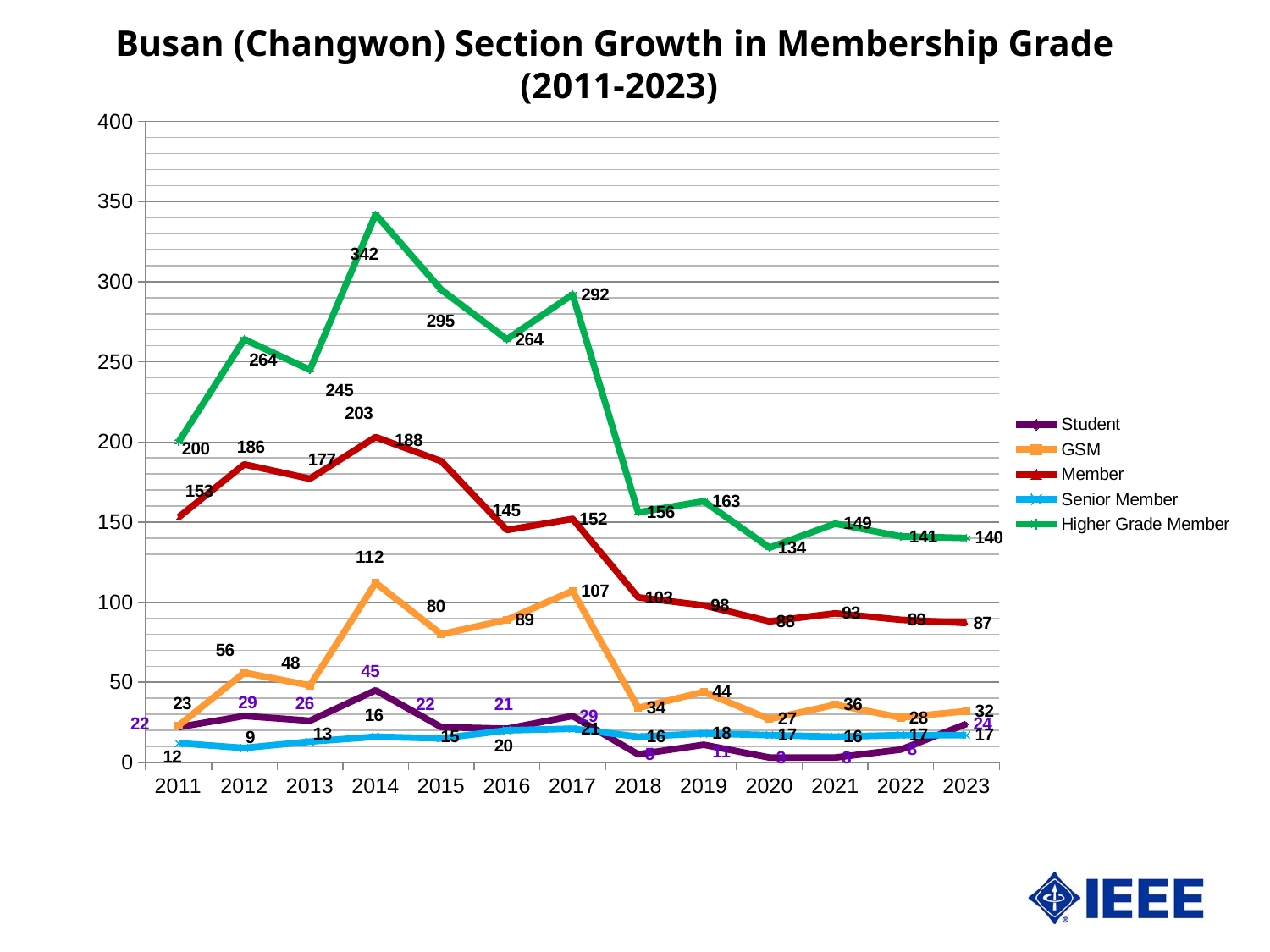
By how much did the Higher Grade Member value fall from 2017 to 2018? 136 In which year does the Higher Grade Member series reach its highest value? 2014 In 2023, which is larger: the Member value or the GSM value? Member How many years are plotted along the x axis? 13 What is the value for GSM in 2014? 112 What is the value for Member in 2011? 153 What is the value for Higher Grade Member in 2014? 342 Is the value for Higher Grade Member in 2015 greater or less than 250? greater What kind of chart is shown on the slide? line chart How many series does the legend list? 5 In which year is the GSM series at its lowest value? 2011 Does the Higher Grade Member series rise or fall from 2017 to 2020? fall